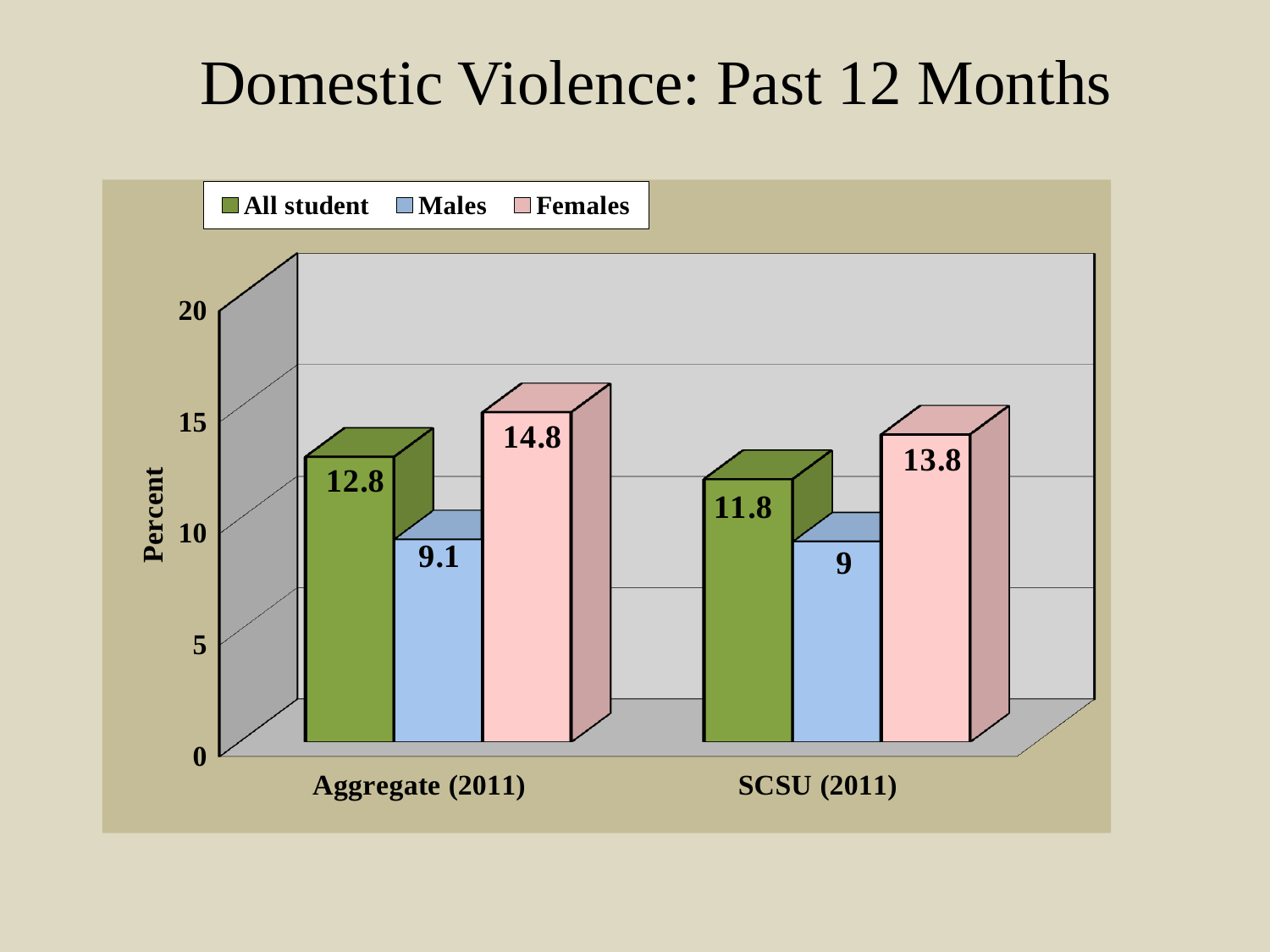
Which series has the highest value in the Aggregate (2011) group? Females What is the value for Males in the SCSU (2011) group? 9 What is the value for Females in the Aggregate (2011) group? 14.8 What kind of chart is shown on the slide? Bar chart How many series does the legend list? 3 Which series has the lowest value in the SCSU (2011) group? Males What is the difference between the All student values for Aggregate (2011) and SCSU (2011)? 1 What is the value for All student in the SCSU (2011) group? 11.8 What is the difference between the Females and Males values in the Aggregate (2011) group? 5.7 Which is larger, the Females value for Aggregate (2011) or for SCSU (2011)? Aggregate (2011) What is the label of the vertical axis? Percent How many categories are shown on the x axis? 2